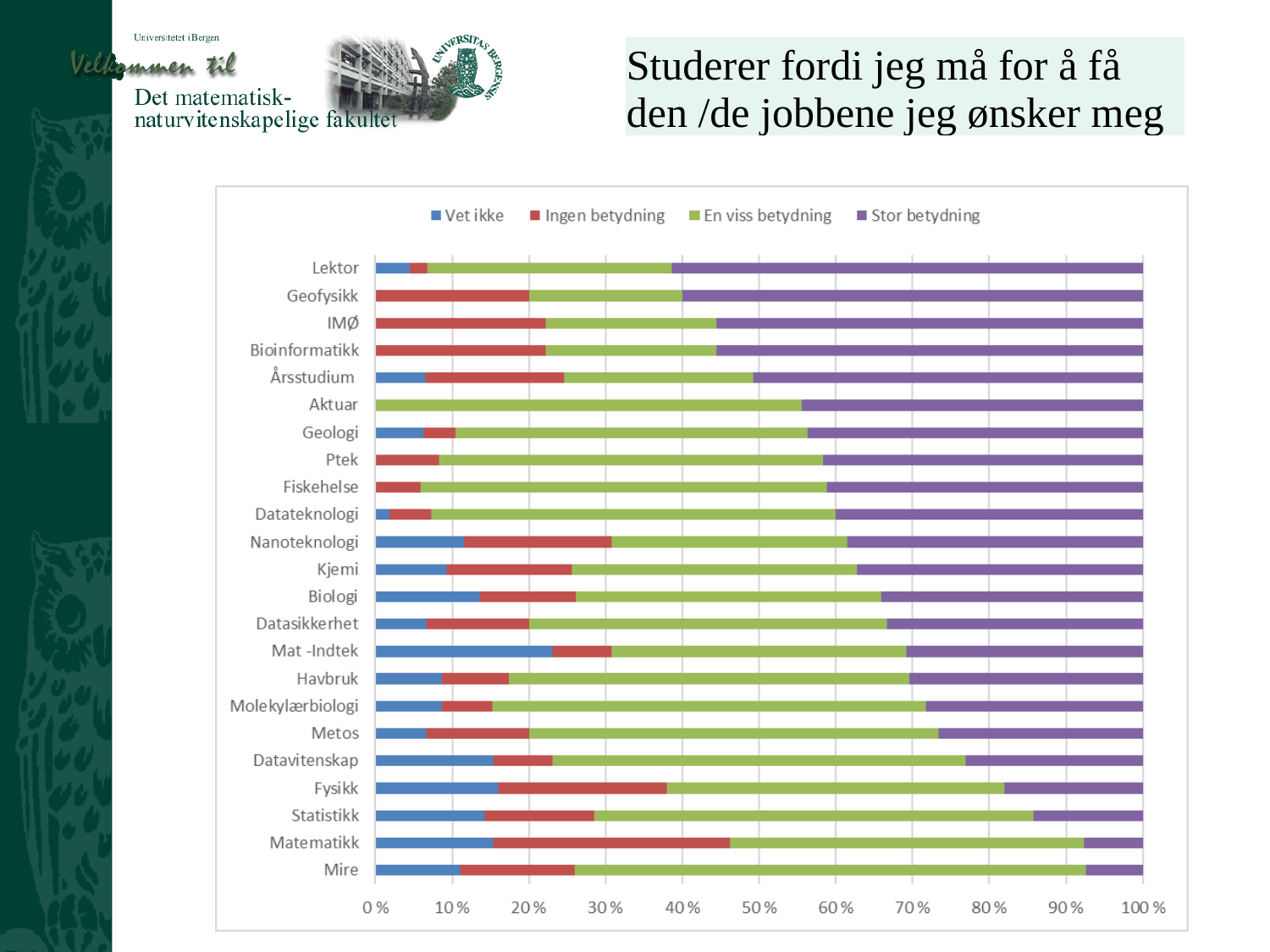
How many series does the legend list? 4 Which category has the largest 'Ingen betydning' share? Matematikk Is the 'Vet ikke' share for Mat -Indtek greater or less than 20%? greater Is the 'Stor betydning' share for Lektor greater or less than 50%? greater Is the 'Stor betydning' share for Mire greater or less than 10%? less What are the four legend entries of the chart? Vet ikke, Ingen betydning, En viss betydning, Stor betydning Which category has the largest 'Vet ikke' share? Mat -Indtek Which colour represents 'Stor betydning' in the chart? Purple What kind of chart is shown on the slide? Stacked bar chart Which has the larger 'Stor betydning' share, Lektor or Mire? Lektor How many study programmes (categories) are plotted on the chart? 23